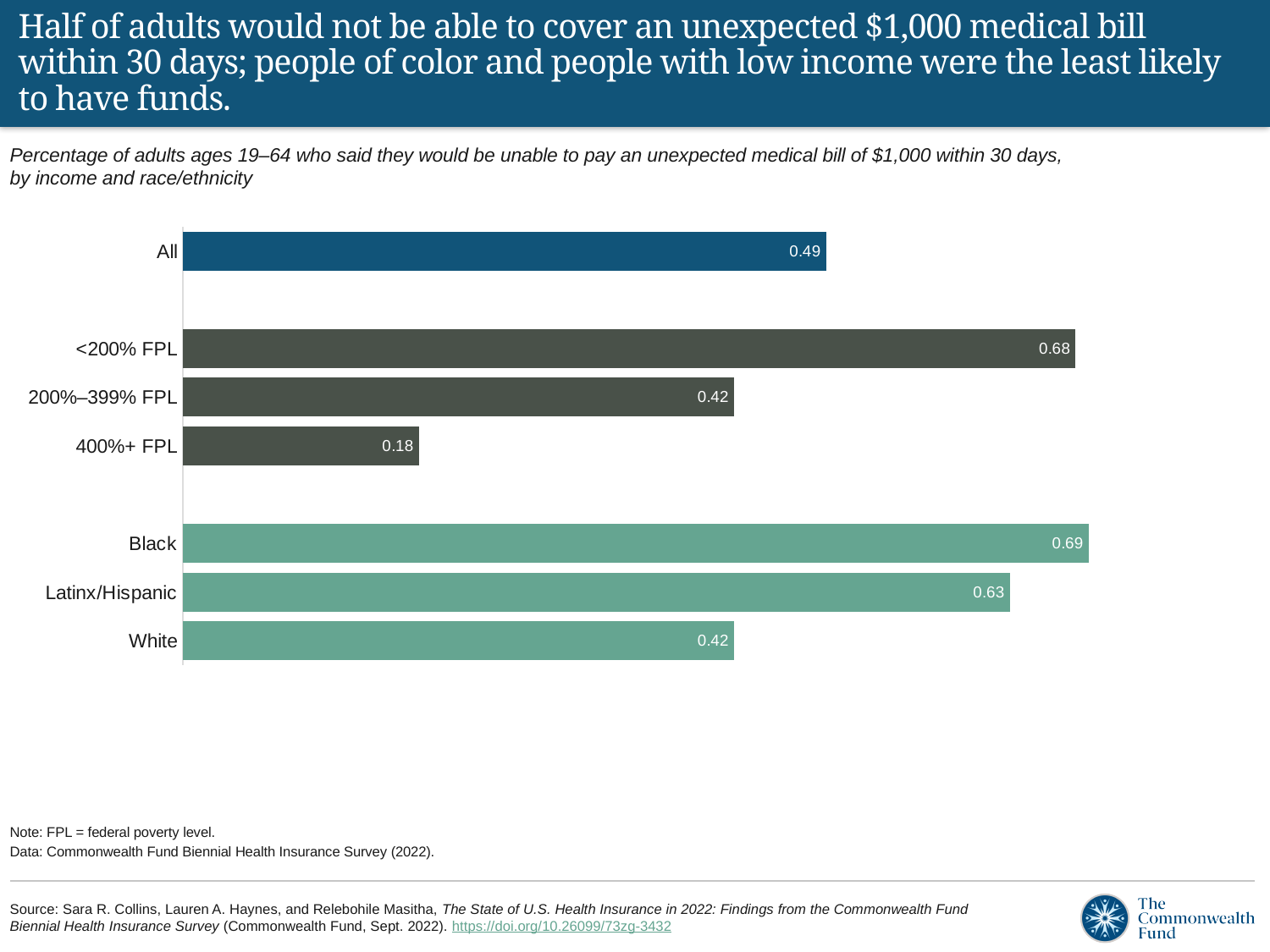
Which is larger, the value for Latinx/Hispanic or the value for 200%–399% FPL? Latinx/Hispanic What is the difference between the values for Black and White? 0.27 According to the note, what does FPL stand for? Federal poverty level How many categories are shown in the chart? 8 Which category has the lowest value? 400%+ FPL What is the value for <200% FPL? 0.68 What is the value for Latinx/Hispanic? 0.63 What kind of chart is shown on the slide? Bar chart What is the value for 400%+ FPL? 0.18 What is the difference between the values for <200% FPL and 400%+ FPL? 0.50 What is the value for All? 0.49 Which category has the highest value? Black